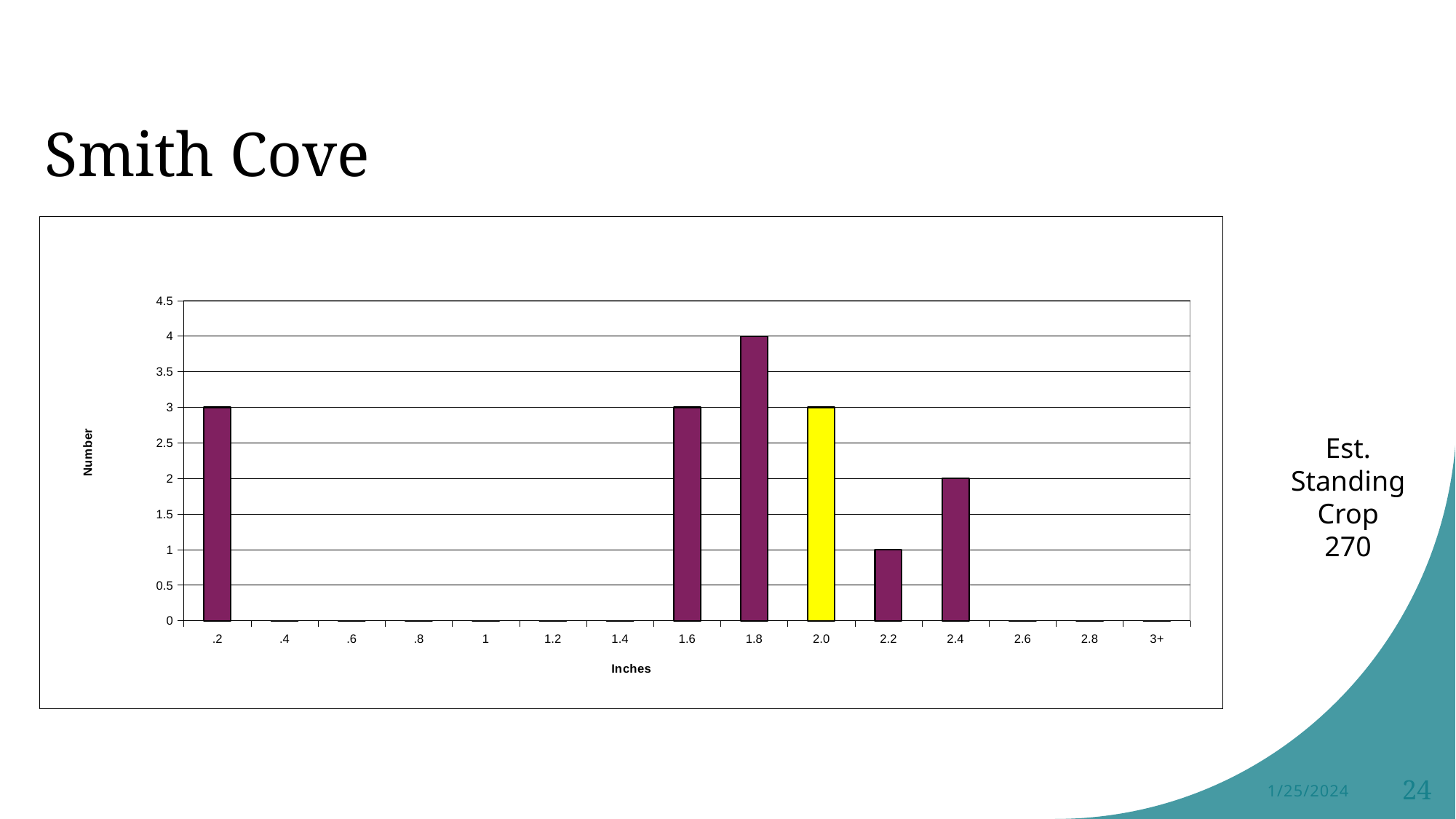
Which is larger, the value for 2.4 inches or the value for 2.2 inches? 2.4 Is the value for 1.6 inches greater or less than 2? greater What is the value for 2.2 inches? 1 What is the value for .2 inches? 3 Which inch category has the highest value? 1.8 How many categories are shown on the x axis? 15 Which inch category is shown with a yellow bar? 2.0 What is the value for 1.8 inches? 4 What kind of chart is shown on the slide? bar chart What is the value for 2.4 inches? 2 What is the label of the y axis? Number What is the difference between the values for 1.8 inches and 2.2 inches? 3